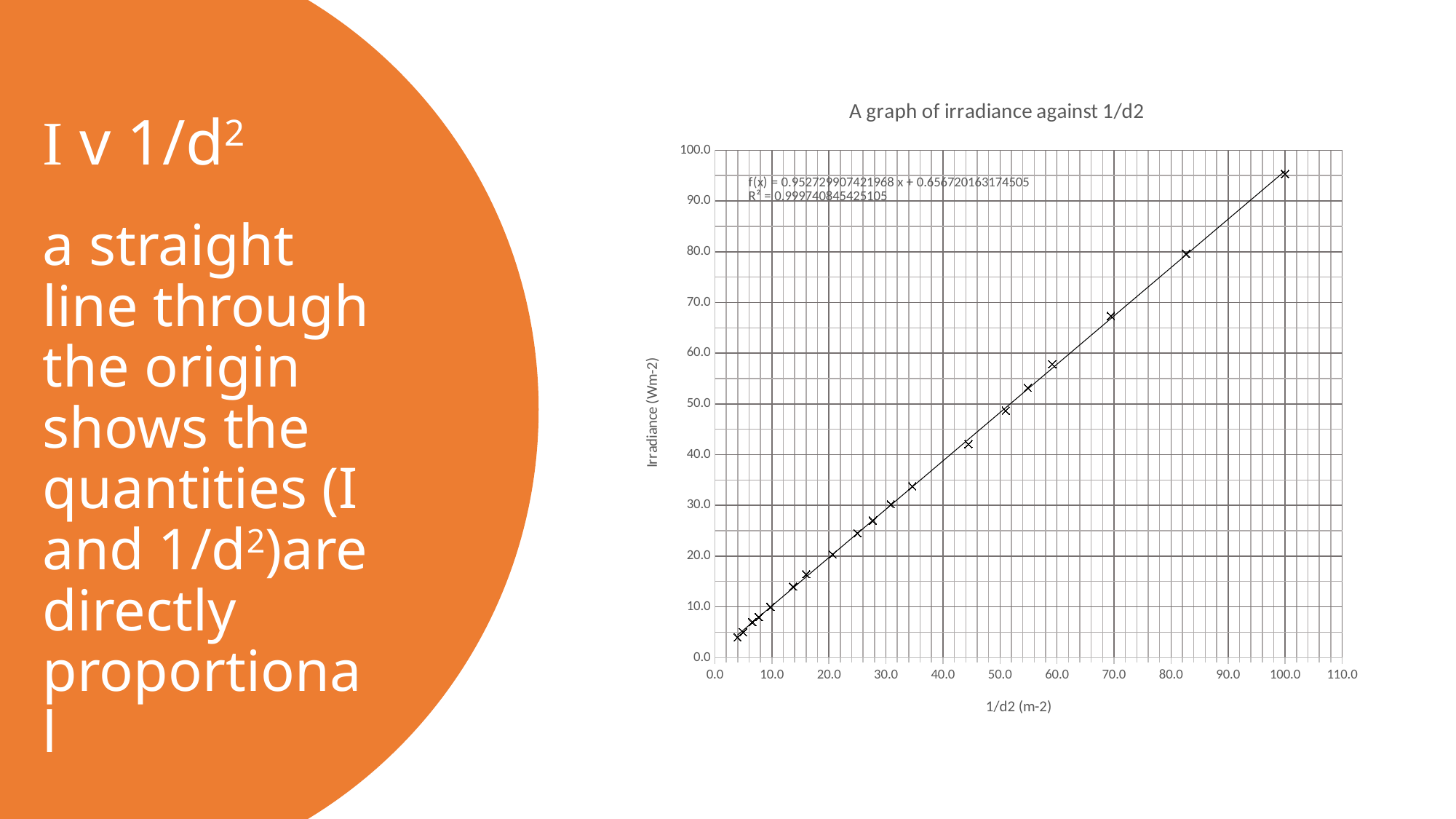
Which has the higher irradiance: the point near 1/d2 = 35.0 or the point near 1/d2 = 59.0? the point near 1/d2 = 59.0 Is the irradiance value for the point at 1/d2 = 100.0 greater or less than 90.0? greater Is the irradiance value for the point near 1/d2 = 83.0 greater or less than 90.0? less Is the irradiance value for the point near 1/d2 = 70.0 greater or less than 60.0? greater What R² value is printed on the chart? R² = 0.999740845425105 What is the equation of the trendline printed on the chart? f(x) = 0.952729907421968 x + 0.656720163174505 What kind of chart is shown on the slide? scatter chart Do the irradiance values rise or fall as 1/d2 increases along the x axis? rise